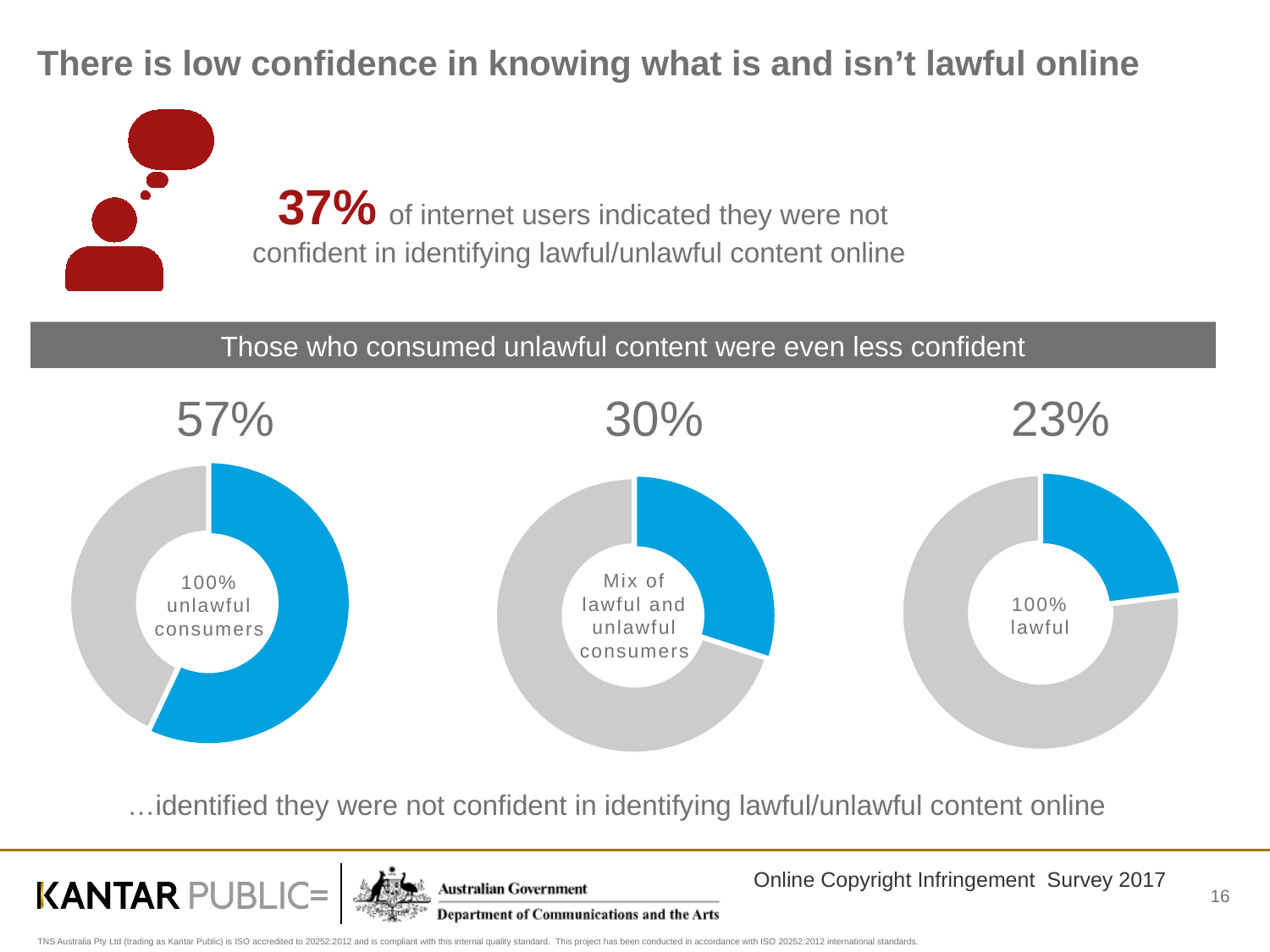
What colour is used for the highlighted (not confident) segment in each donut chart? Blue What percentage of 100% lawful consumers were not confident in identifying lawful/unlawful content online? 23% How many donut charts are shown on the slide? 3 What type of chart is used to show the share of not-confident consumers in each group? Donut chart What is the difference in percentage points between the 100% unlawful consumers and the 100% lawful consumers who were not confident? 34 What percentage of 100% unlawful consumers were not confident in identifying lawful/unlawful content online? 57% What percentage of the mix of lawful and unlawful consumers were not confident in identifying lawful/unlawful content online? 30% Which group has a larger share of not-confident consumers: the mix of lawful and unlawful consumers or the 100% lawful consumers? Mix of lawful and unlawful consumers Which consumer group has the highest share of people not confident in identifying lawful/unlawful content online? 100% unlawful consumers Which consumer group has the lowest share of people not confident in identifying lawful/unlawful content online? 100% lawful What percentage of all internet users indicated they were not confident in identifying lawful/unlawful content online? 37% What is the difference in percentage points between the 100% unlawful consumers and the mix of lawful and unlawful consumers who were not confident? 27